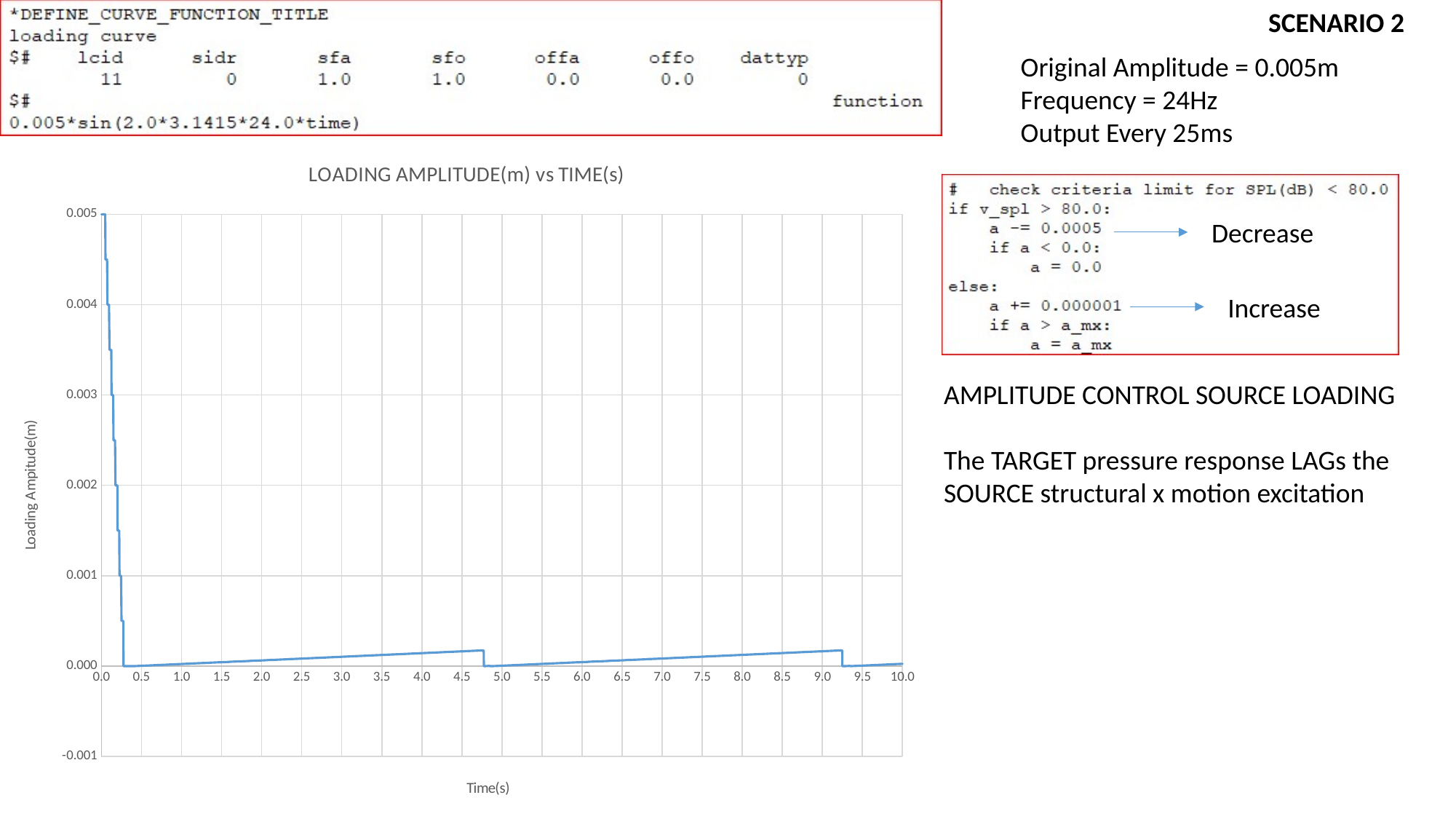
Between time 0.0 s and 0.5 s, does the loading amplitude rise or fall? fall Which is larger, the loading amplitude at time 0.0 s or at time 5.0 s? time 0.0 s What is the label of the vertical axis of the chart? Loading Amplitude(m) What is the loading amplitude at time 0.0 s, where the line starts? 0.005 Is the loading amplitude at time 2.0 s greater or less than 0.001? less What is the largest time value shown on the horizontal axis? 10.0 Is the loading amplitude at time 9.0 s greater or less than 0.001? less Is the loading amplitude at time 0.0 s greater or less than 0.004? greater What is the title of the chart? LOADING AMPLITUDE(m) vs TIME(s) At what time does the loading amplitude reach its highest value? 0.0 What kind of chart is shown on the slide? line chart Between time 1.0 s and 4.5 s, does the loading amplitude rise or fall? rise